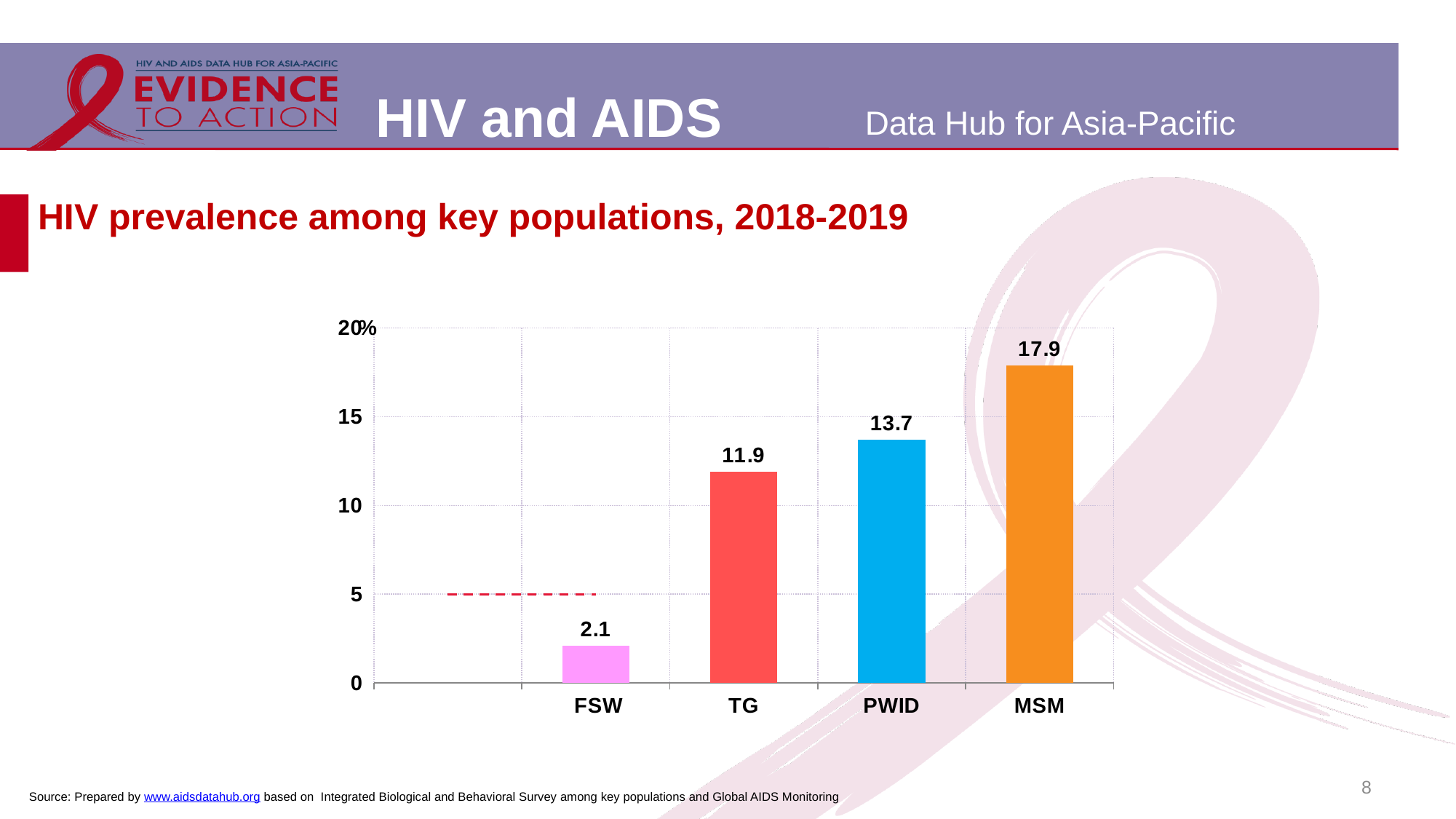
What is the HIV prevalence value shown for FSW? 2.1 Which key population has the highest HIV prevalence? MSM What is the HIV prevalence value shown for MSM? 17.9 What is the HIV prevalence value shown for TG? 11.9 What kind of chart is shown on the slide? bar chart How many key populations are shown on the chart? 4 What is the title of the chart on the slide? HIV prevalence among key populations, 2018-2019 Is the value for FSW greater or less than 5? less Which has a higher HIV prevalence, TG or PWID? PWID What is the HIV prevalence value shown for PWID? 13.7 What is the difference between the HIV prevalence for MSM and for PWID? 4.2 Which key population has the lowest HIV prevalence? FSW